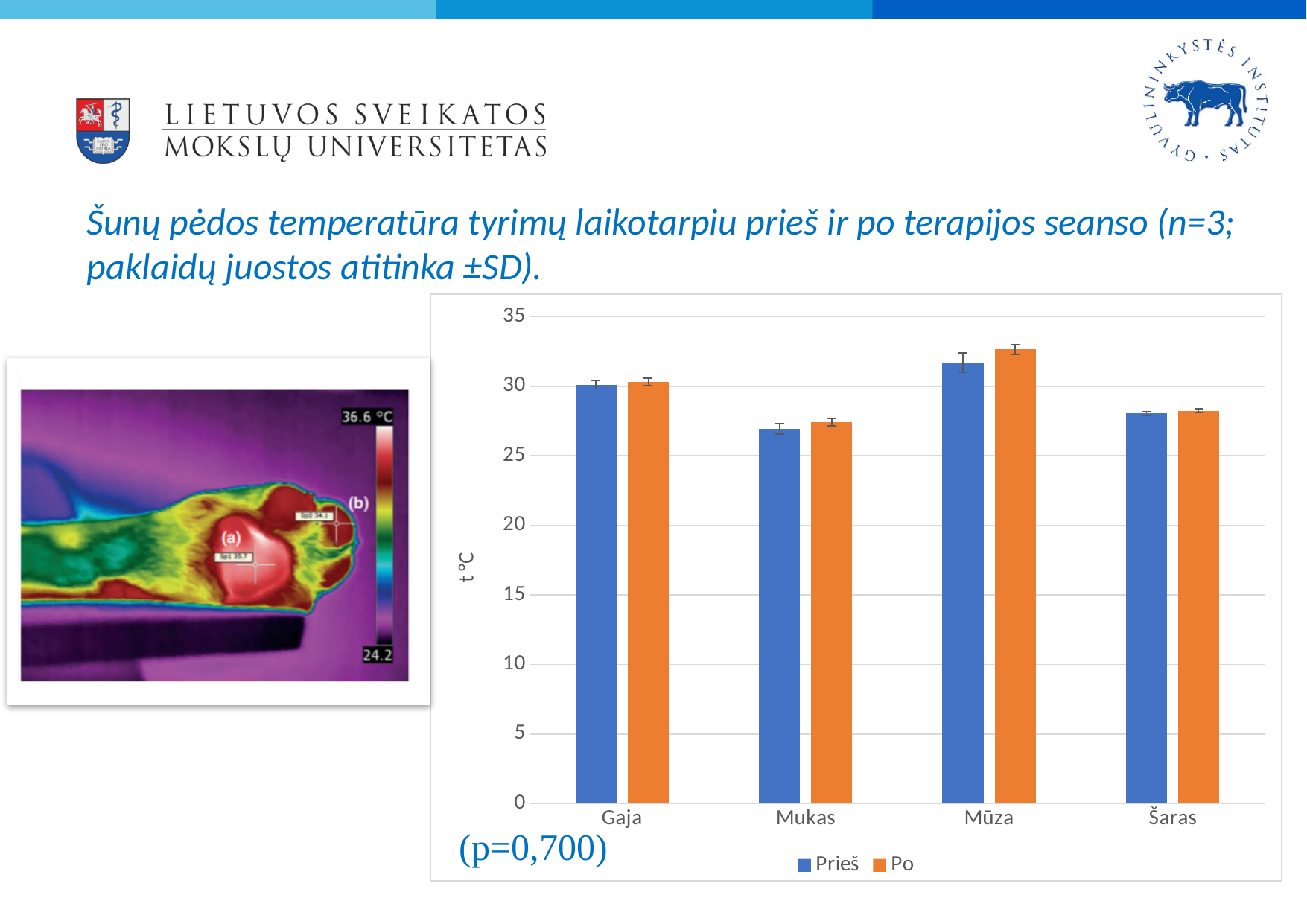
How many dogs (categories) are shown on the x axis of the chart? 4 Which is larger: the 'Prieš' value for Gaja or the 'Prieš' value for Šaras? Gaja Which dog has the highest 'Po' temperature in the chart? Mūza Which dog has the lowest 'Prieš' temperature in the chart? Mukas What is the label of the vertical axis of the chart? t°C How many series does the chart legend list? 2 Which dog has the highest 'Prieš' temperature in the chart? Mūza What kind of chart is shown on the slide? bar chart Is the 'Prieš' value for Mukas greater or less than 30? less Is the 'Prieš' value for Šaras greater or less than 25? greater What are the two series named in the chart legend? Prieš and Po Is the 'Po' value for Mūza greater or less than 30? greater